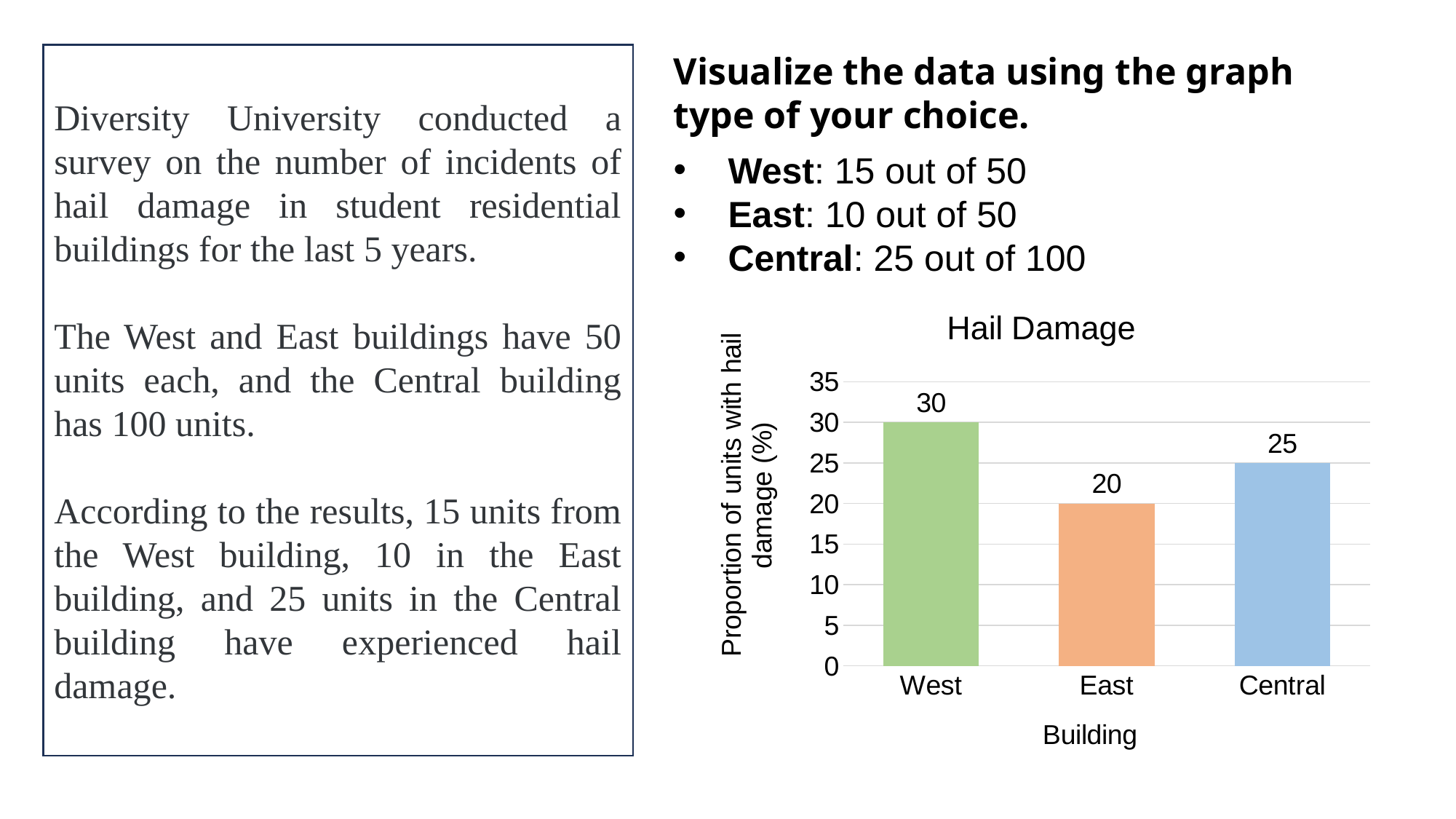
What kind of chart is the Hail Damage chart? Bar chart Which building has the lowest proportion of units with hail damage? East Which is larger, the value for Central or the value for East? Central What is the label of the y axis in the Hail Damage chart? Proportion of units with hail damage (%) What is the title of the chart? Hail Damage What is the difference between the values for West and East? 10 What is the value for Central in the Hail Damage chart? 25 Which building has the highest proportion of units with hail damage? West What is the value for West in the Hail Damage chart? 30 What is the difference between the values for West and Central? 5 What is the value for East in the Hail Damage chart? 20 How many buildings are shown in the Hail Damage chart? 3